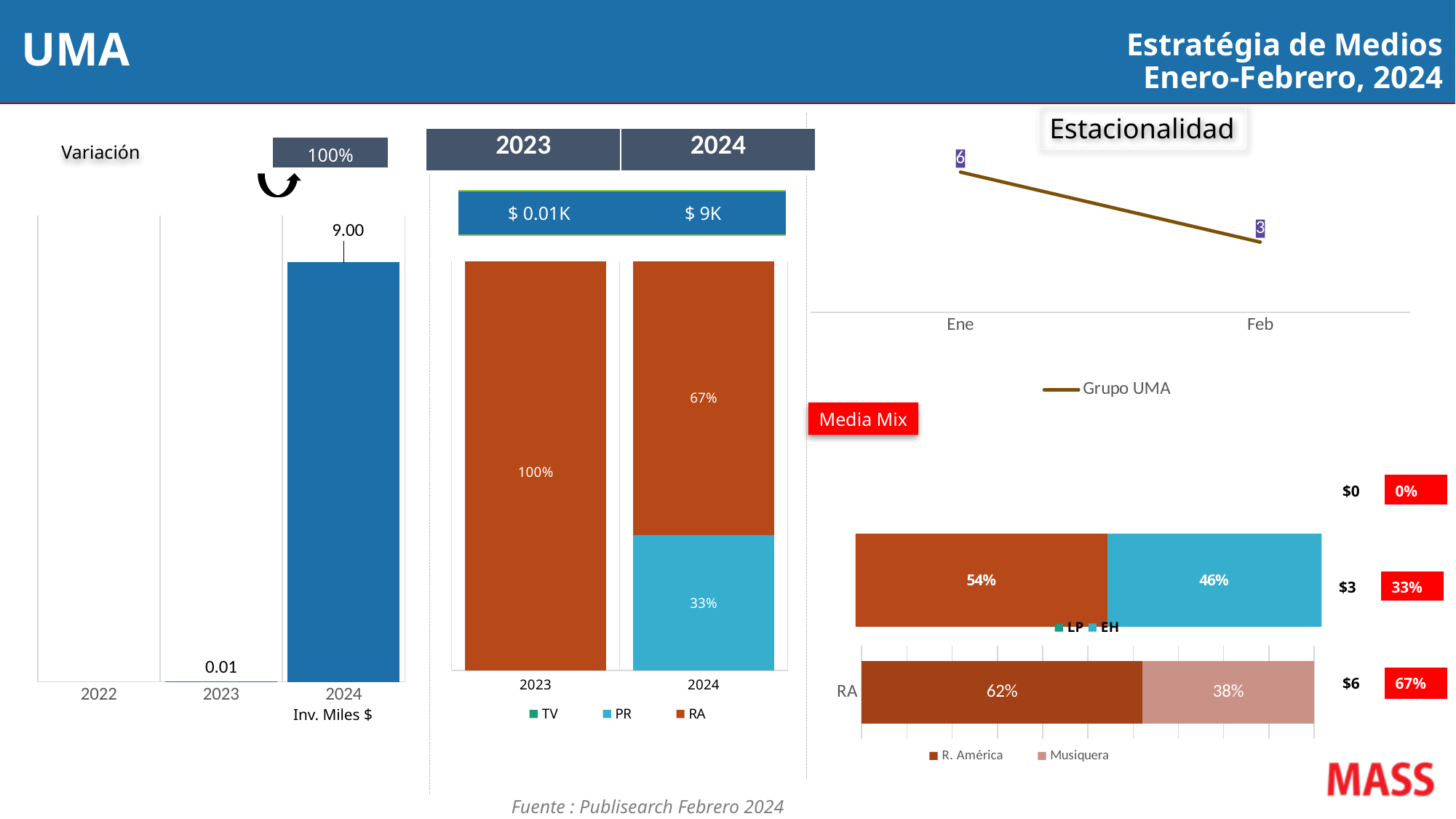
In the middle stacked bar chart comparing 2023 and 2024, what share does PR have in 2024? 33% In the left bar chart labelled 'Inv. Miles $', what is the value for 2023? 0.01 In the Media Mix RA bar, which is larger, R. América or Musiquera? R. América In the 'Estacionalidad' line chart, what is the value for Ene? 6 In the middle stacked bar chart comparing 2023 and 2024, what share does RA have in 2024? 67% In the left bar chart labelled 'Inv. Miles $', how many year categories are shown on the x axis? 3 In the Media Mix stacked bar with LP and EH, what is the share for EH? 46% In the 'Estacionalidad' line chart, do the values rise or fall from Ene to Feb? fall In the left bar chart labelled 'Inv. Miles $', what is the value for 2024? 9.00 In the left bar chart labelled 'Inv. Miles $', which year has the highest value? 2024 In the middle stacked bar chart comparing 2023 and 2024, how many series does the legend list? 3 In the left bar chart labelled 'Inv. Miles $', what is the difference between the 2024 and 2023 values? 8.99